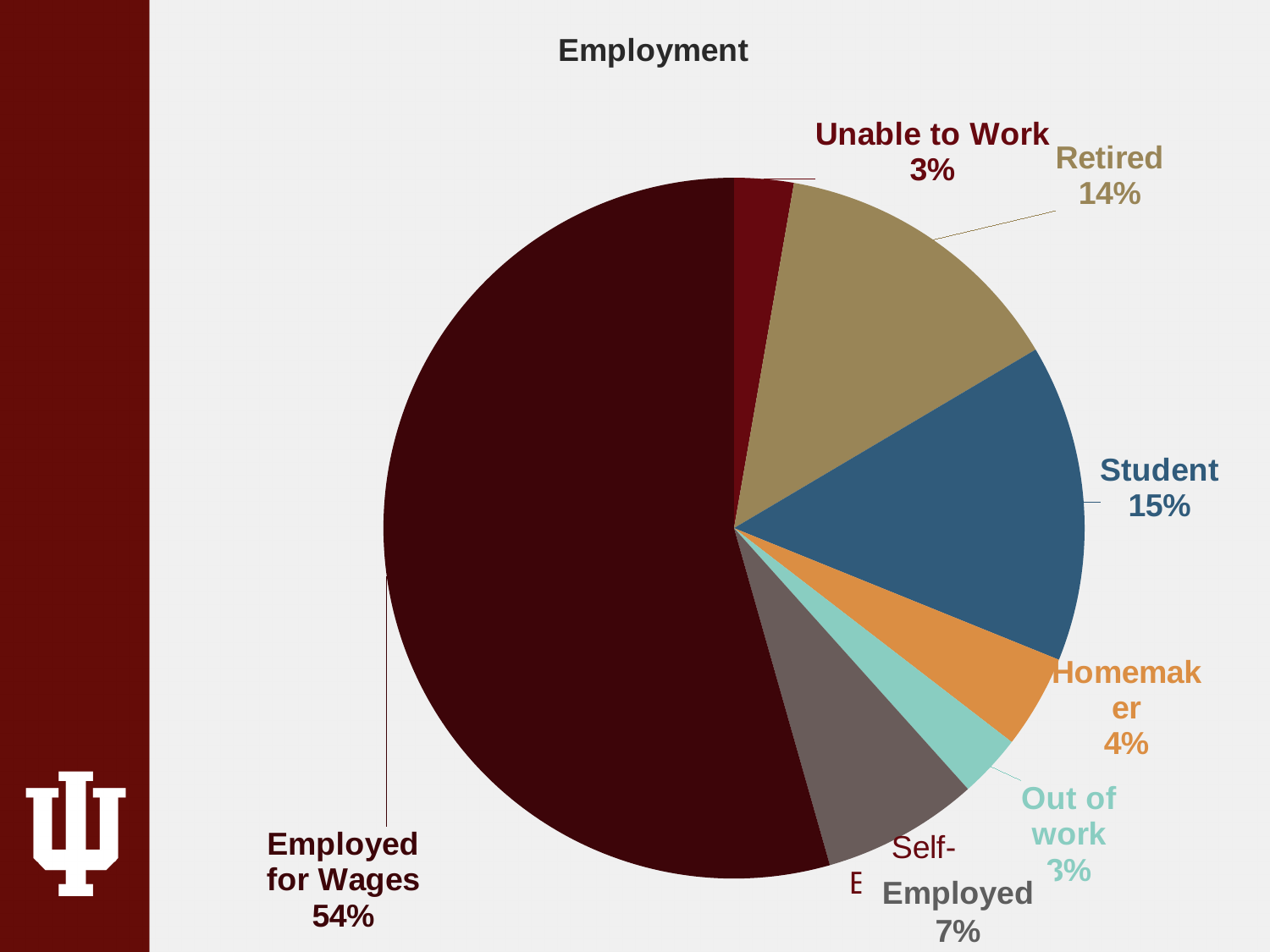
How many categories are shown in the pie chart? 7 What is the title of the chart? Employment Which category has the largest share of the pie? Employed for Wages What percentage is shown for Student? 15% What percentage is shown for Homemaker? 4% What percentage is shown for Self-Employed? 7% What percentage is shown for Retired? 14% Which is larger, the share for Self-Employed or the share for Homemaker? Self-Employed What percentage of the pie is Employed for Wages? 54% What type of chart is shown on the slide? Pie chart What is the difference in percentage points between Student and Retired? 1 What is the difference in percentage points between Employed for Wages and Student? 39